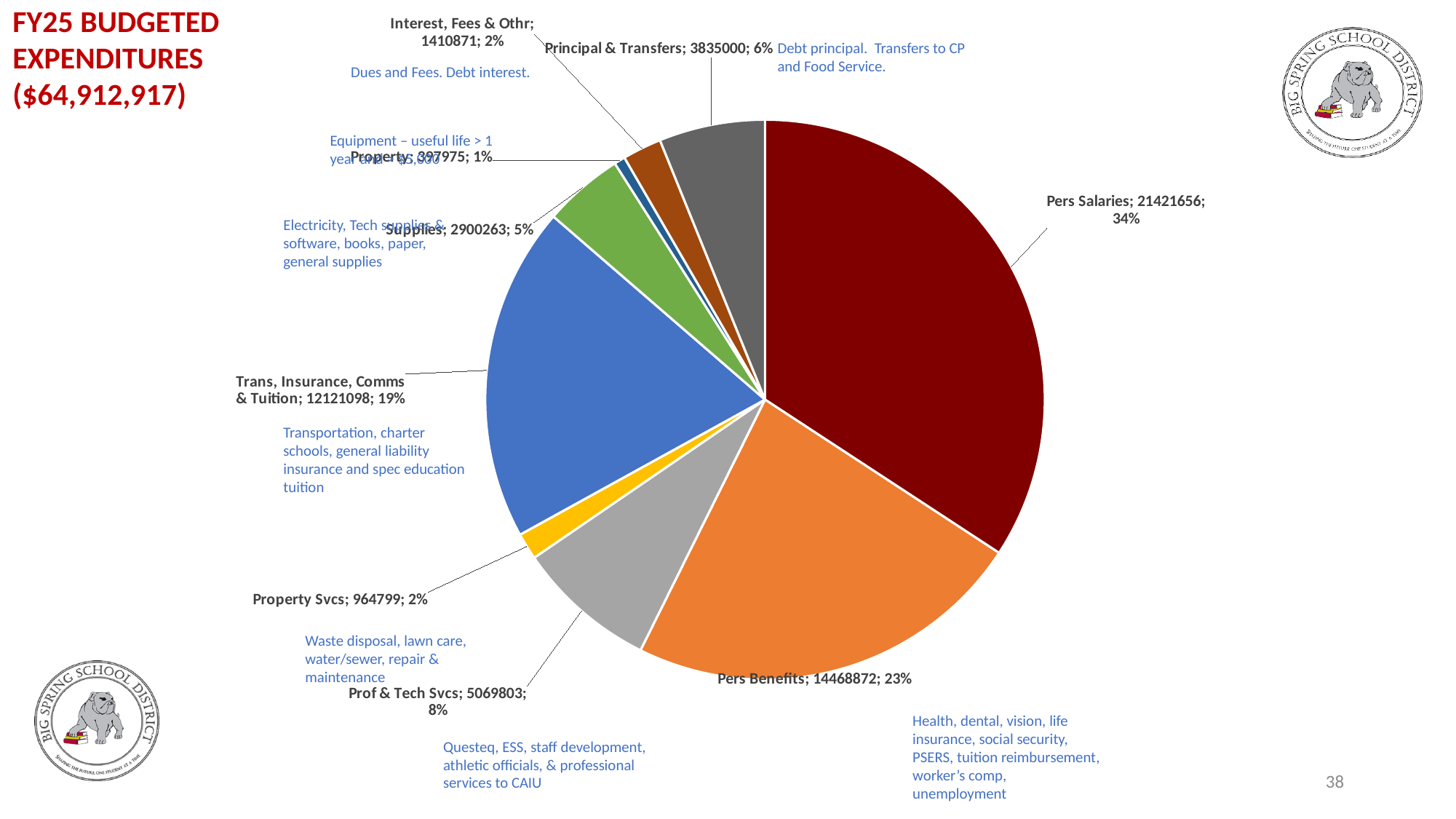
What share of the pie does Pers Benefits represent? 23% What is the value for Trans, Insurance, Comms & Tuition? 12121098 Which category has the smallest slice of the pie? Property What is the difference between the Pers Salaries value and the Pers Benefits value? 6952784 Which category has the largest slice of the pie? Pers Salaries What kind of chart is shown on the slide? pie chart Which is larger, Prof & Tech Svcs or Principal & Transfers? Prof & Tech Svcs What is the budgeted value for Pers Salaries? 21421656 What total expenditure amount is given in the chart title? $64,912,917 What share of the pie does Supplies represent? 5% What is the value for Interest, Fees & Othr? 1410871 How many categories are shown in the pie chart? 9